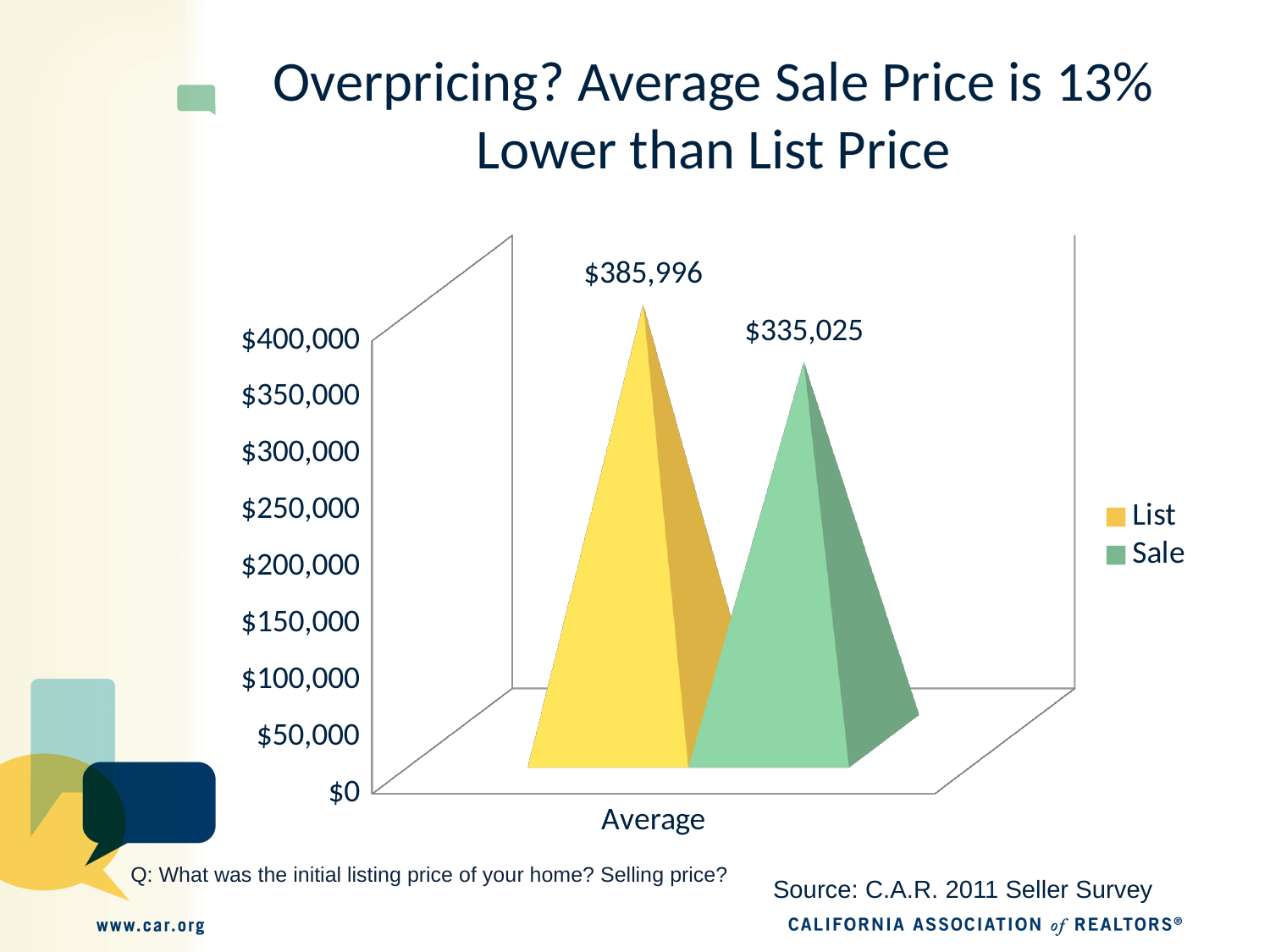
How many categories are shown on the x axis? 1 Which colour represents the Sale series in the legend? Green What kind of chart is shown on the slide? Bar chart What is the difference between the List value and the Sale value? $50,971 How many series does the legend list? 2 Is the value for Sale greater or less than $300,000? greater What is the label of the category on the x axis? Average Is the value for List greater or less than $400,000? less Which series has the lowest value on the chart? Sale What is the value for Sale in the Average category? $335,025 What is the value for List in the Average category? $385,996 Which series has the higher value, List or Sale? List